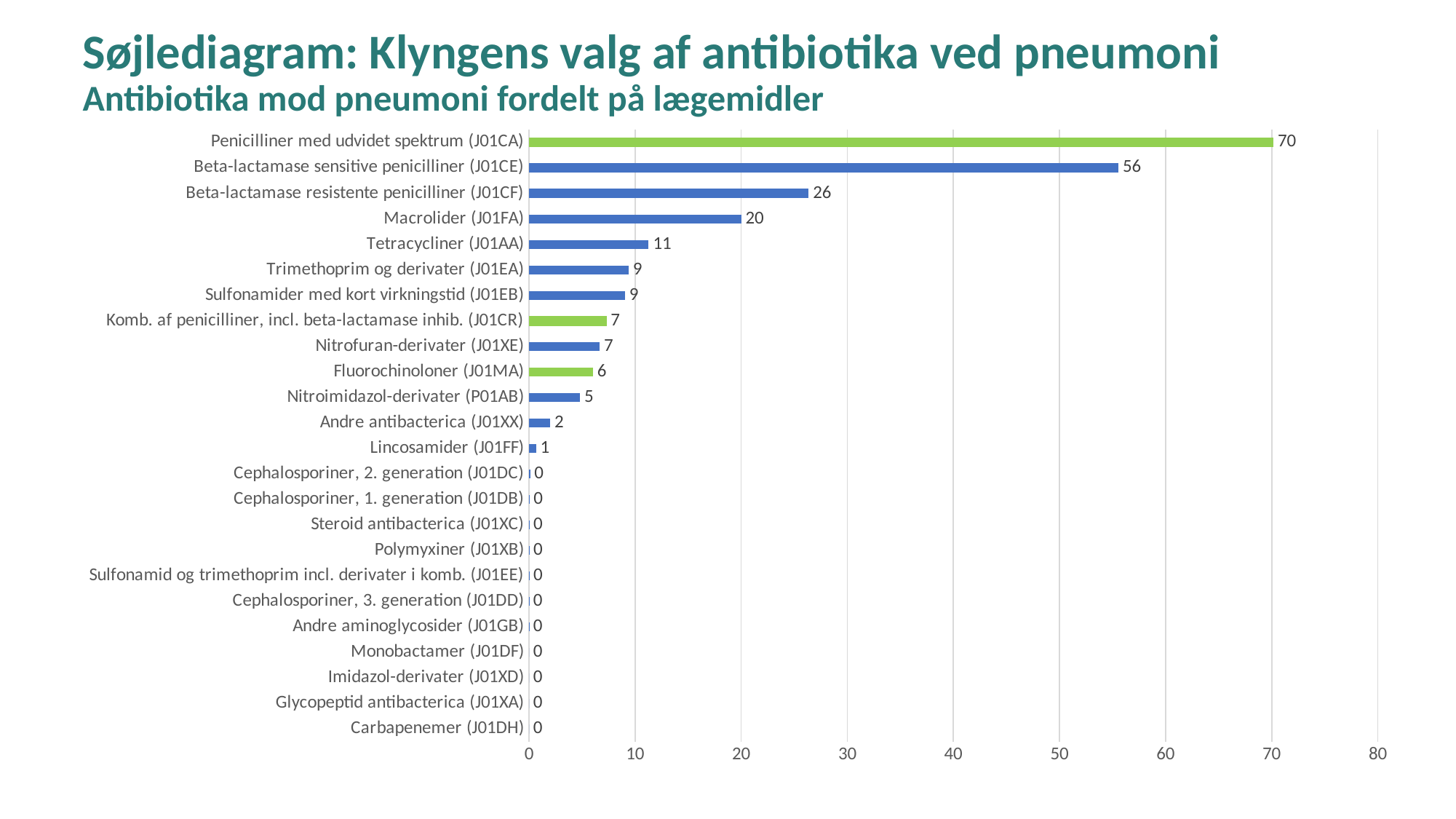
How many bars on the chart are coloured green? 3 What is the value for Macrolider (J01FA)? 20 What is the value for Penicilliner med udvidet spektrum (J01CA)? 70 What kind of chart is shown on the slide? bar chart What is the difference between the values for Beta-lactamase resistente penicilliner (J01CF) and Macrolider (J01FA)? 6 Which is larger, the value for Fluorochinoloner (J01MA) or the value for Nitroimidazol-derivater (P01AB)? Fluorochinoloner (J01MA) Is the value for Beta-lactamase sensitive penicilliner (J01CE) greater or less than 50? greater What is the value for Tetracycliner (J01AA)? 11 What is the difference between the values for Penicilliner med udvidet spektrum (J01CA) and Beta-lactamase sensitive penicilliner (J01CE)? 14 What is the value for Beta-lactamase sensitive penicilliner (J01CE)? 56 How many categories are shown on the chart? 24 Which category has the highest value? Penicilliner med udvidet spektrum (J01CA)